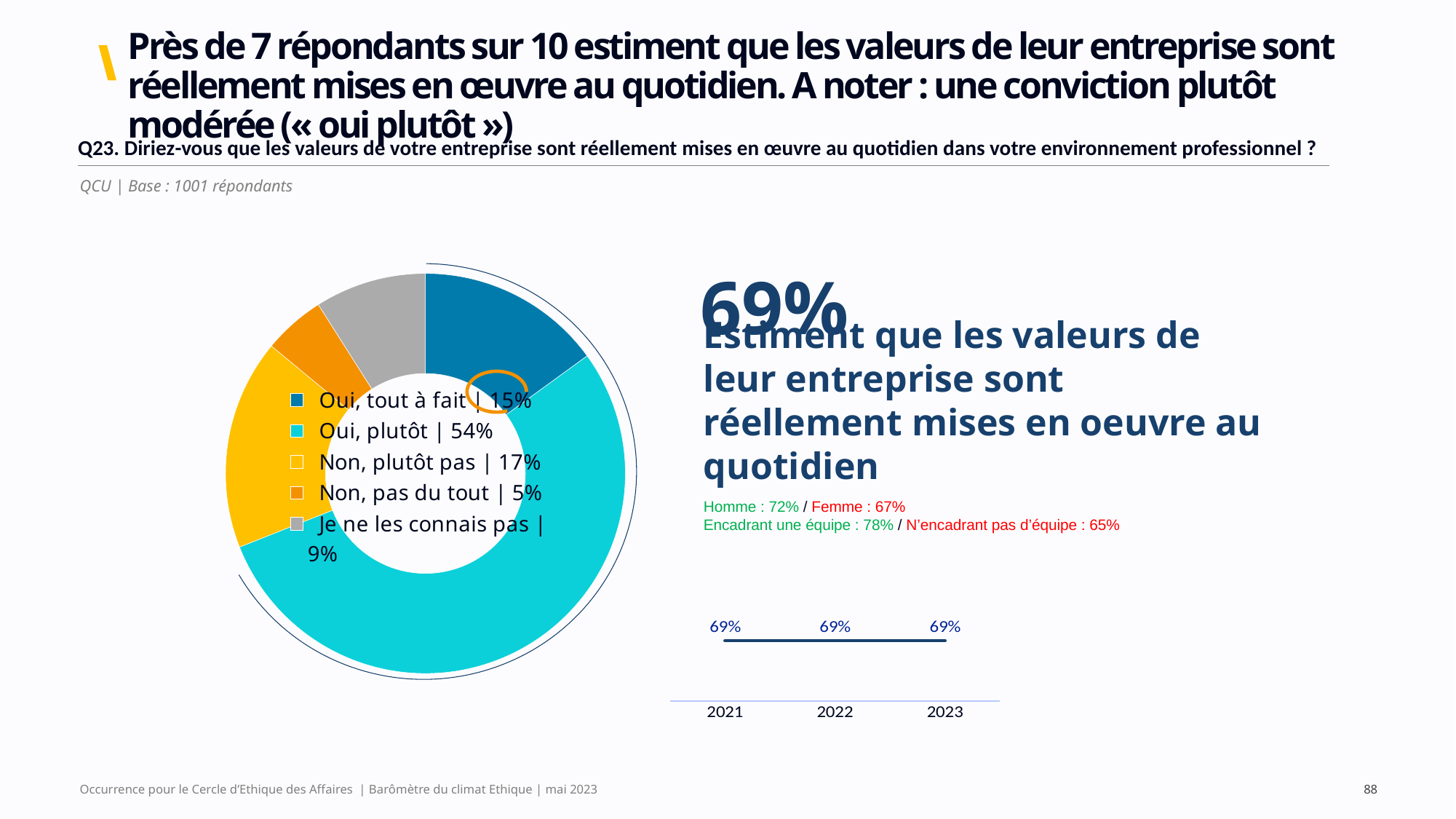
In the donut chart on the left, what share of respondents answered "Oui, plutôt"? 54% In the donut chart on the left, which response category has the largest share? Oui, plutôt In the line chart at the bottom right, what is the value shown for 2023? 69% What kind of chart is shown on the left of the slide? Donut (pie) chart In the donut chart on the left, what share of respondents answered "Non, pas du tout"? 5% How many response categories does the legend of the donut chart on the left list? 5 In the donut chart on the left, what is the difference in percentage points between "Non, plutôt pas" and "Oui, tout à fait"? 2 percentage points In the donut chart on the left, which is larger: the share for "Non, plutôt pas" or the share for "Je ne les connais pas"? Non, plutôt pas In the donut chart on the left, which response category has the smallest share? Non, pas du tout In the line chart at the bottom right, do the values rise, fall or stay flat from 2021 to 2023? Stay flat In the donut chart on the left, what share of respondents answered "Oui, tout à fait"? 15% In the donut chart on the left, what share of respondents answered "Je ne les connais pas"? 9%